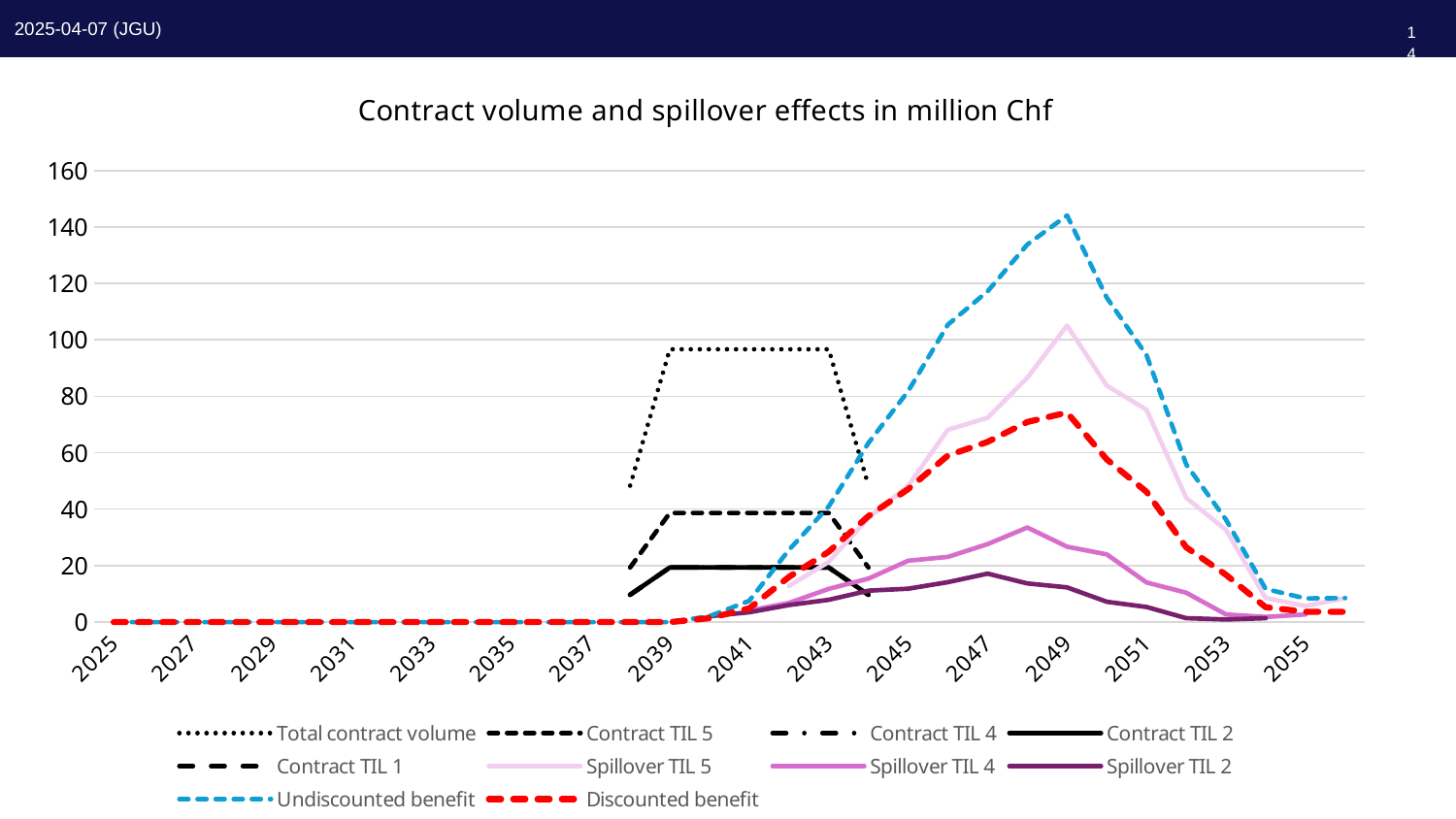
Does the Undiscounted benefit line rise or fall between 2049 and 2055? fall How many series does the legend list? 10 In 2049, which is higher: Undiscounted benefit or Discounted benefit? Undiscounted benefit Is the peak value of Spillover TIL 4 greater or less than 40? less Is the peak value of Discounted benefit (around 2049) greater or less than 60? greater Is the plateau value of Total contract volume between 2040 and 2043 greater or less than 80? greater In 2049, which is higher: Spillover TIL 5 or Spillover TIL 4? Spillover TIL 5 What is the title of the chart? Contract volume and spillover effects in million Chf What kind of chart is shown on the slide? line chart Which series reaches the highest value on the chart? Undiscounted benefit